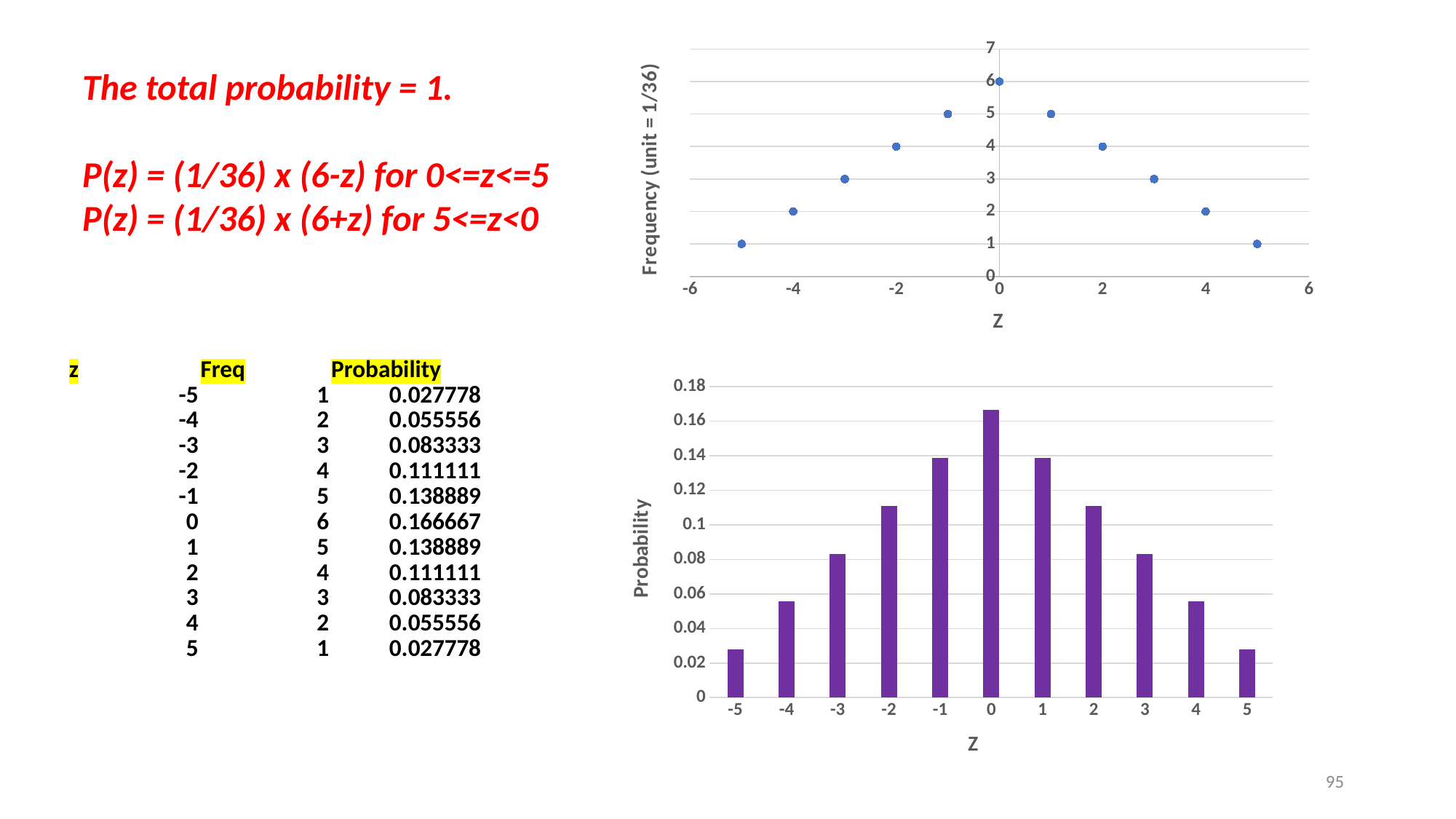
In the top chart (Frequency vs Z), which Z value has the highest frequency? 0 In the bottom chart (Probability vs Z), is the probability for Z = 5 greater or less than 0.04? less In the top chart (Frequency vs Z), what is the frequency at Z = 0? 6 In the bottom chart (Probability vs Z), is the probability for Z = 0 greater or less than 0.16? greater In the top chart (Frequency vs Z), what is the difference between the frequency at Z = -1 and the frequency at Z = -5? 4 In the top chart (Frequency vs Z), how many data points are plotted? 11 What kind of chart is the bottom chart (Probability vs Z)? bar chart In the top chart (Frequency vs Z), what is the frequency at Z = -3? 3 In the bottom chart (Probability vs Z), which Z value has the highest probability? 0 In the bottom chart (Probability vs Z), which is larger, the probability for Z = -2 or the probability for Z = 3? Z = -2 In the top chart (Frequency vs Z), what is the frequency at Z = 4? 2 In the top chart (Frequency vs Z), do the frequencies rise or fall as Z goes from 0 to 5? fall